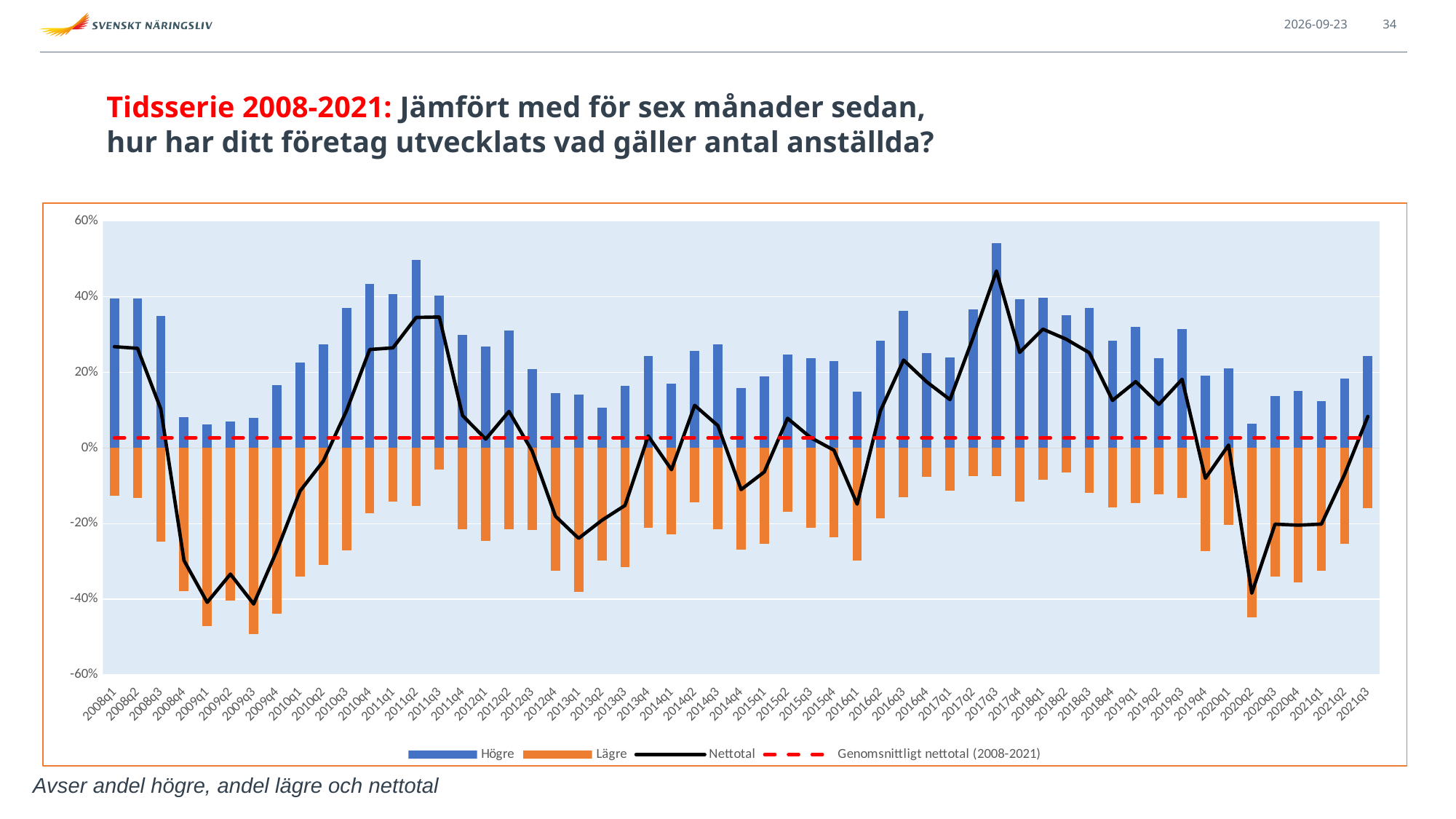
Is the Högre value for 2011q2 greater or less than 40%? greater Which quarter has the larger Högre value, 2017q3 or 2020q2? 2017q3 How many quarters (categories) are shown on the x axis? 55 What colour are the Lägre bars? Orange Does the Nettotal line rise or fall from 2016q1 to 2017q3? rise What kind of chart is shown on the slide? A bar chart combined with line series How many series does the legend list? 4 Is the Nettotal value for 2013q1 greater or less than -20%? less Is the Högre value for 2017q3 greater or less than 40%? greater What does the red dashed line represent according to the legend? Genomsnittligt nettotal (2008-2021) In which quarter is the Högre bar highest? 2017q3